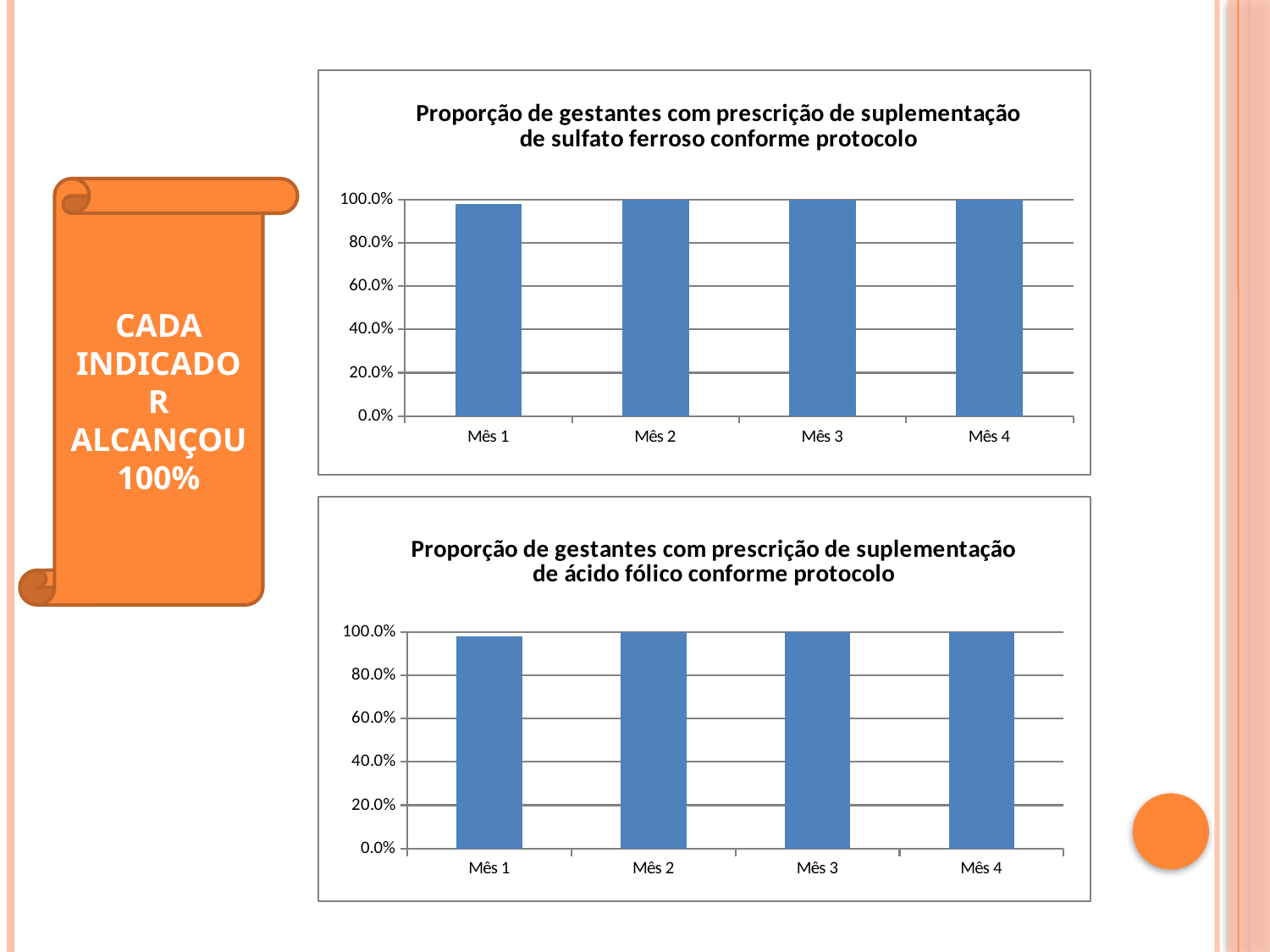
In the top chart (sulfato ferroso), what is the value for Mês 2? 100.0% What type of chart is the bottom chart, 'Proporção de gestantes com prescrição de suplementação de ácido fólico conforme protocolo'? bar chart In the bottom chart (ácido fólico), what is the value for Mês 3? 100.0% In the bottom chart (ácido fólico), is the value for Mês 1 greater or less than 80.0%? greater What type of chart is the top chart, 'Proporção de gestantes com prescrição de suplementação de sulfato ferroso conforme protocolo'? bar chart What is the title of the top chart? Proporção de gestantes com prescrição de suplementação de sulfato ferroso conforme protocolo In the top chart (sulfato ferroso), how many months are shown on the x axis? 4 In the top chart (sulfato ferroso), is the value for Mês 1 greater or less than 80.0%? greater In the top chart (sulfato ferroso), what is the value for Mês 4? 100.0% In the bottom chart (ácido fólico), what is the highest value shown on the y axis? 100.0% In the top chart (sulfato ferroso), is the value for Mês 3 greater or less than 60.0%? greater In the bottom chart (ácido fólico), how many categories are plotted? 4